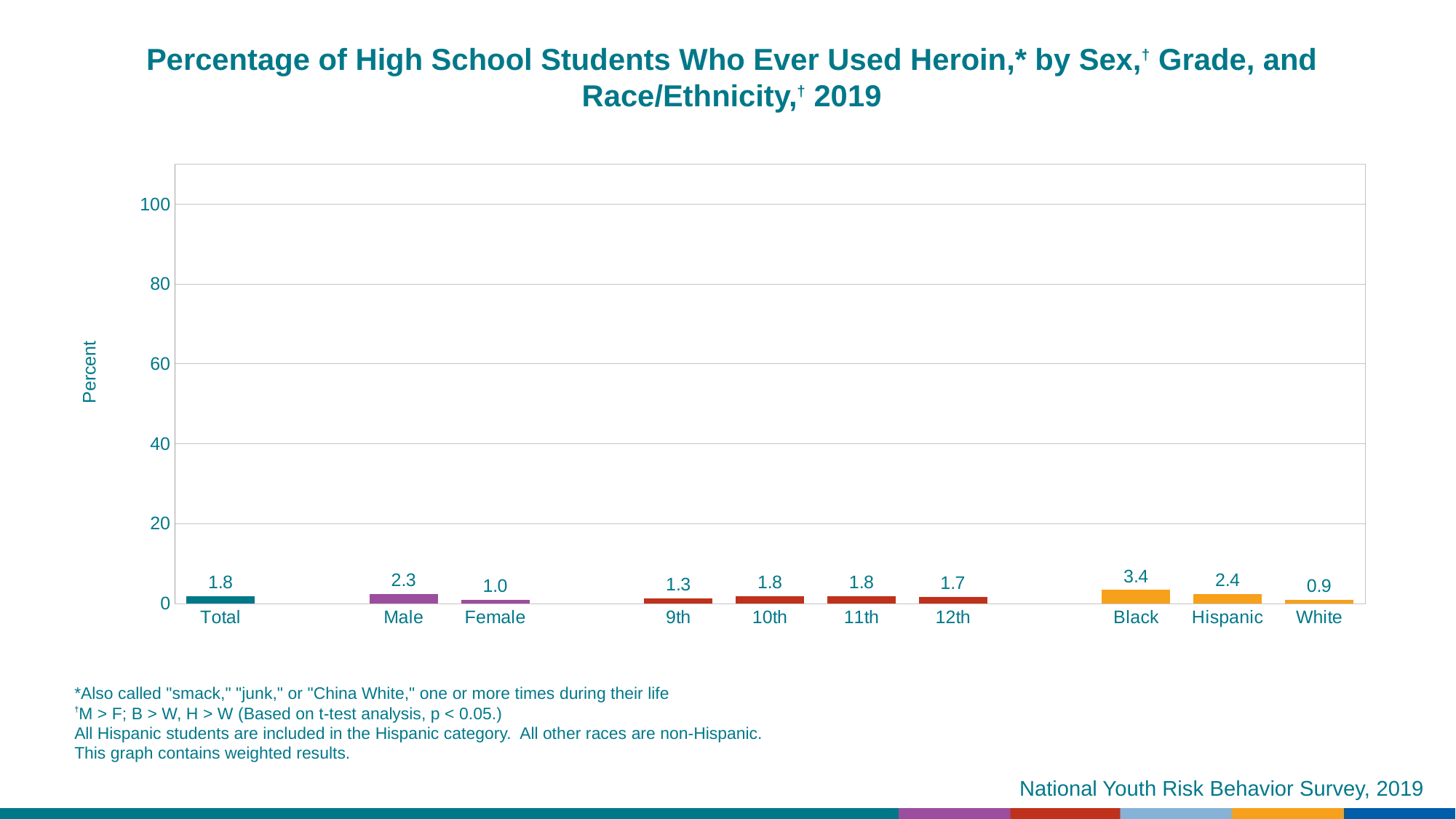
Which category has the highest value? Black Which is larger, the value for Hispanic or the value for 12th grade? Hispanic What is the value for 9th grade? 1.3 What is the label of the y axis? Percent How many categories are shown on the x axis? 10 What is the difference between the values for Black and White? 2.5 What is the difference between the values for Male and Female? 1.3 What is the value for Black? 3.4 Is the value for Total greater or less than 20? less What is the value for Male? 2.3 What kind of chart is this? bar chart Which category has the lowest value? White